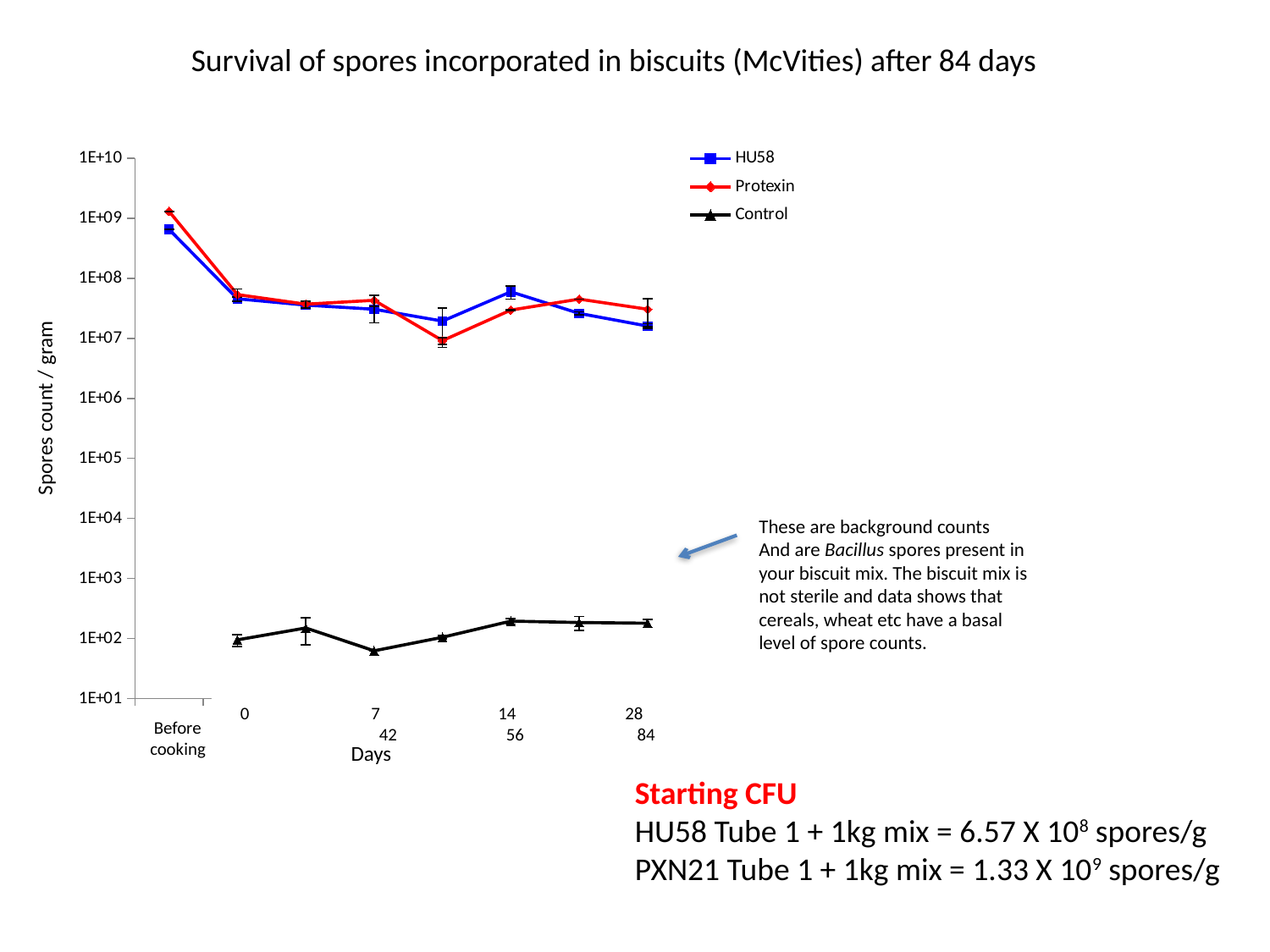
Does the HU58 spore count rise or fall from 'Before cooking' to day 0? Fall Is the value for HU58 before cooking greater or less than 1E+09? less Is the value for Control at day 7 greater or less than 1E+02? less Which series is plotted with the lowest spore counts throughout the chart? Control How many series does the legend list? 3 What kind of chart is shown on the slide? Line chart How many time points are plotted along the x axis, including 'Before cooking'? 8 What is the title of the chart? Survival of spores incorporated in biscuits (McVities) after 84 days At day 14, which series has the higher spore count, HU58 or Protexin? HU58 Is the value for HU58 at day 84 greater or less than 1E+07? greater Before cooking, which series has the higher spore count, HU58 or Protexin? Protexin